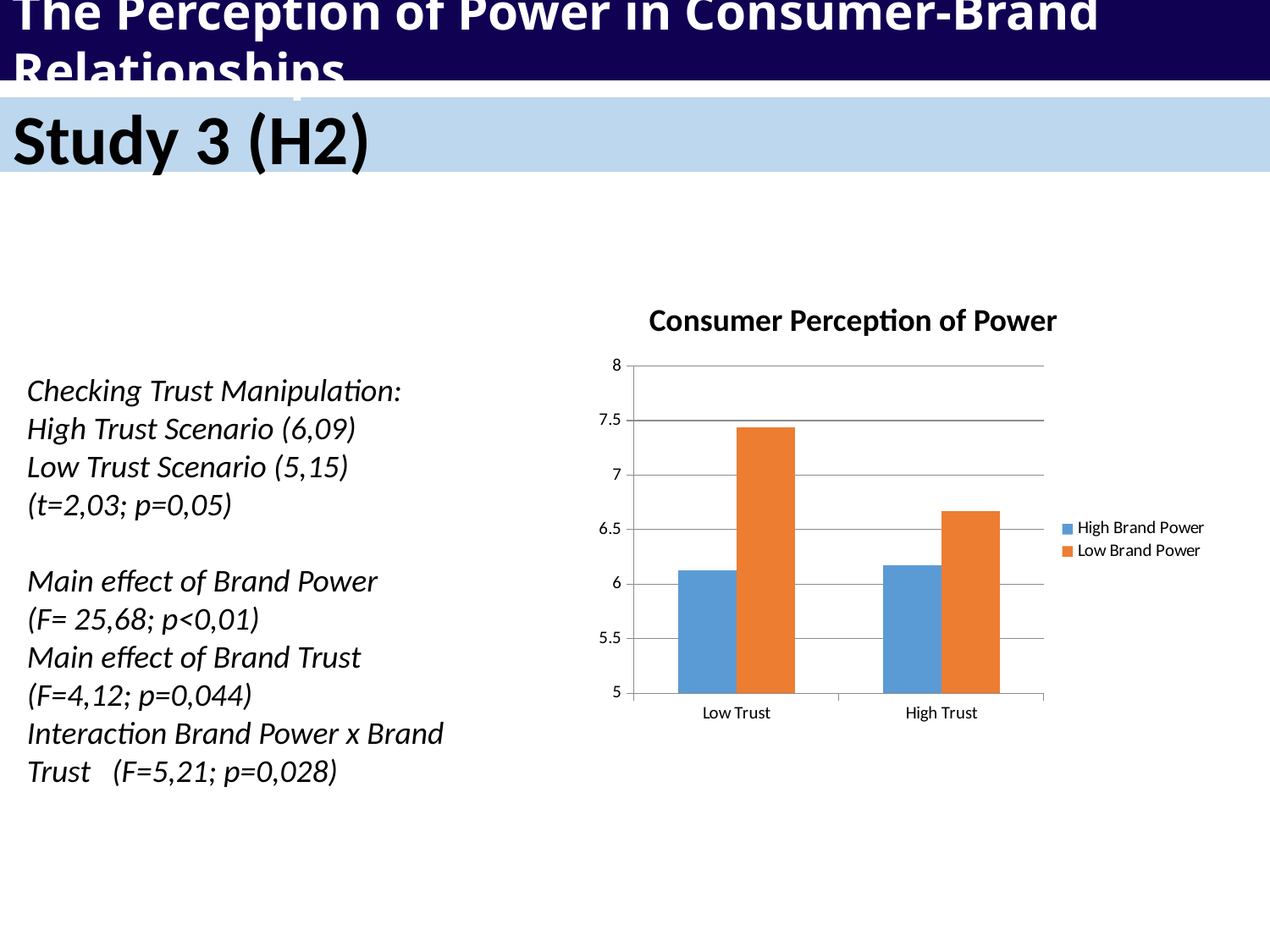
How many categories are shown on the x axis of the chart? 2 Is the value for Low Brand Power at Low Trust greater or less than 7? greater What is the title of the chart? Consumer Perception of Power In the Low Trust category, which is larger: High Brand Power or Low Brand Power? Low Brand Power Does the Low Brand Power value rise or fall from Low Trust to High Trust? fall Is the value for High Brand Power at Low Trust greater or less than 6.5? less Is the value for Low Brand Power at High Trust greater or less than 6.5? greater How many series does the chart's legend list? 2 In the High Trust category, which is larger: High Brand Power or Low Brand Power? Low Brand Power Which bar in the chart is the highest? Low Brand Power at Low Trust What kind of chart is shown on the slide? bar chart Which series is shown in orange in the chart? Low Brand Power